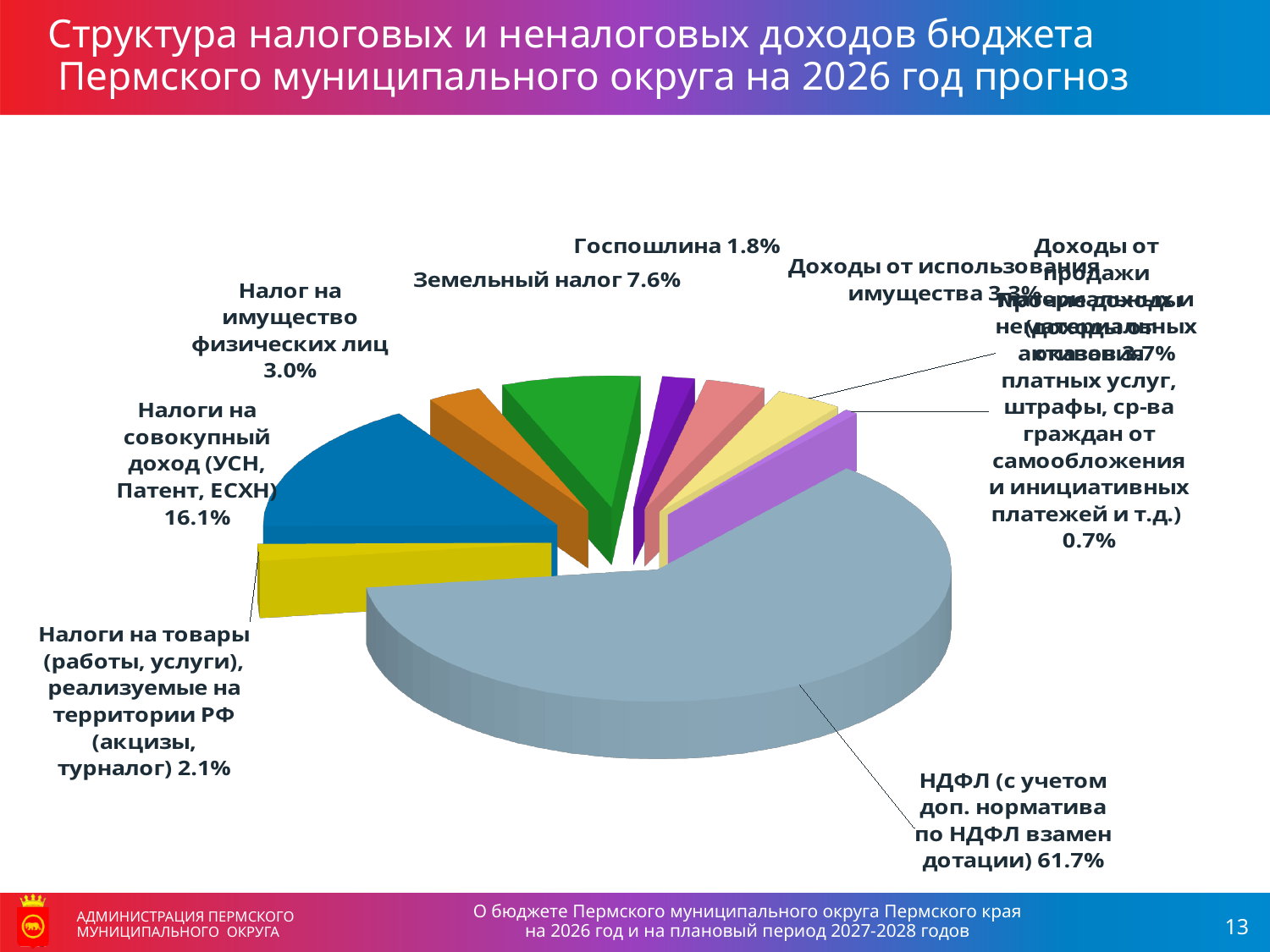
What share of the budget revenue is НДФЛ (с учетом доп. норматива по НДФЛ взамен дотации)? 61.7% What share is shown for Налоги на совокупный доход (УСН, Патент, ЕСХН)? 16.1% Which is larger: the share of Земельный налог or the share of Налог на имущество физических лиц? Земельный налог What share is shown for Налоги на товары (работы, услуги), реализуемые на территории РФ (акцизы, турналог)? 2.1% Which category has the largest share of the pie? НДФЛ (с учетом доп. норматива по НДФЛ взамен дотации) What kind of chart is shown on the slide? pie chart What share is shown for Госпошлина? 1.8% What share is shown for Налог на имущество физических лиц? 3.0% What is the difference between the share of НДФЛ (61.7%) and the share of Налоги на совокупный доход (16.1%)? 45.6% What is the difference between the share of Налог на имущество физических лиц and the share of Госпошлина? 1.2% What share is shown for Земельный налог? 7.6% What is the title of the slide containing the chart? Структура налоговых и неналоговых доходов бюджета Пермского муниципального округа на 2026 год прогноз